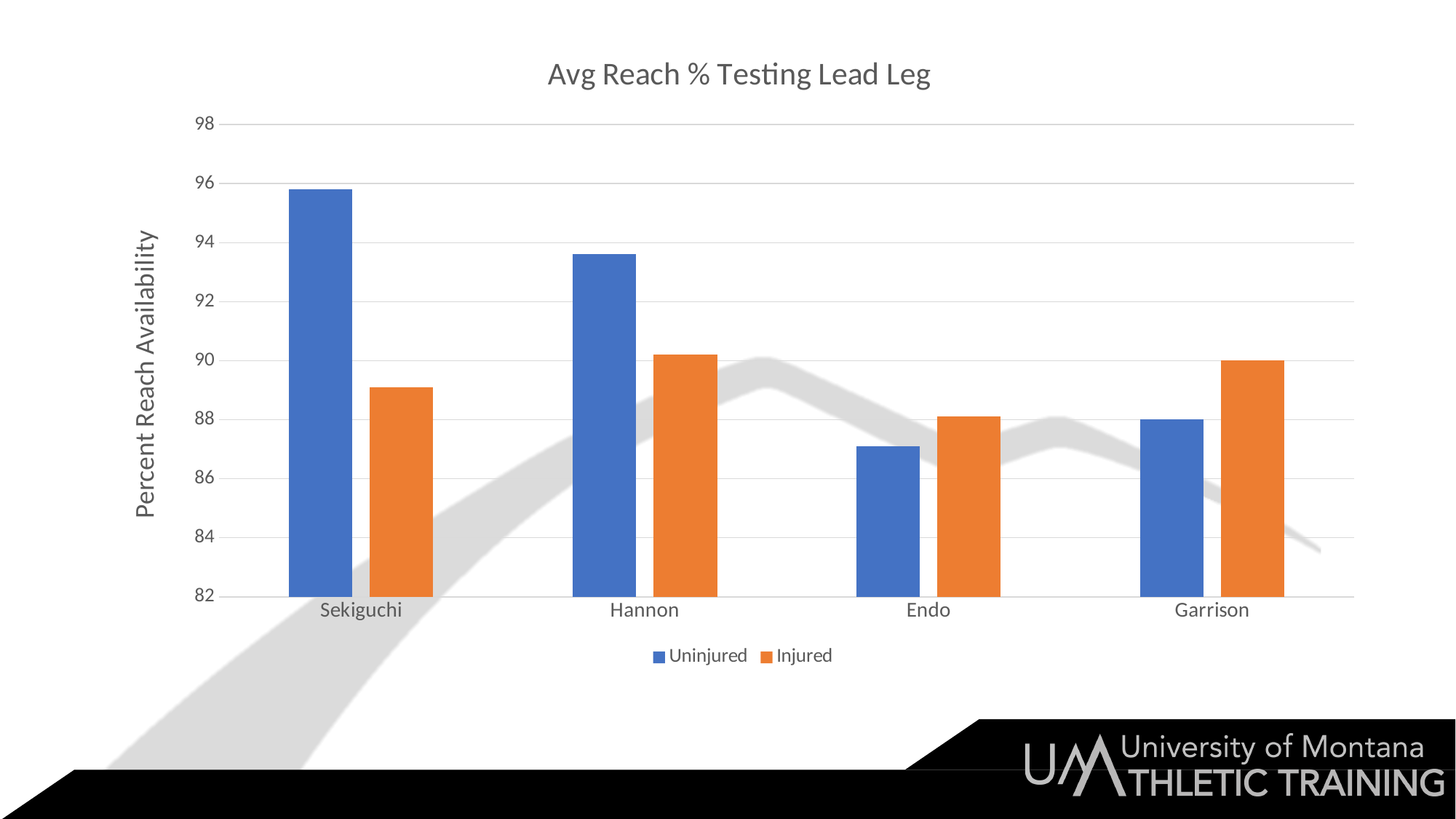
Is the Uninjured value for Hannon greater or less than 92? greater For Sekiguchi, which is larger, the Uninjured value or the Injured value? Uninjured For Garrison, which is larger, the Uninjured value or the Injured value? Injured Is the Injured value for Sekiguchi greater or less than 90? less What is the label on the vertical axis? Percent Reach Availability Which category has the highest Uninjured value? Sekiguchi How many series does the legend list? 2 Which category has the lowest Injured value? Endo How many categories are shown on the x axis? 4 What kind of chart is shown on the slide? bar chart Which category has the lowest Uninjured value? Endo What is the title of the chart? Avg Reach % Testing Lead Leg